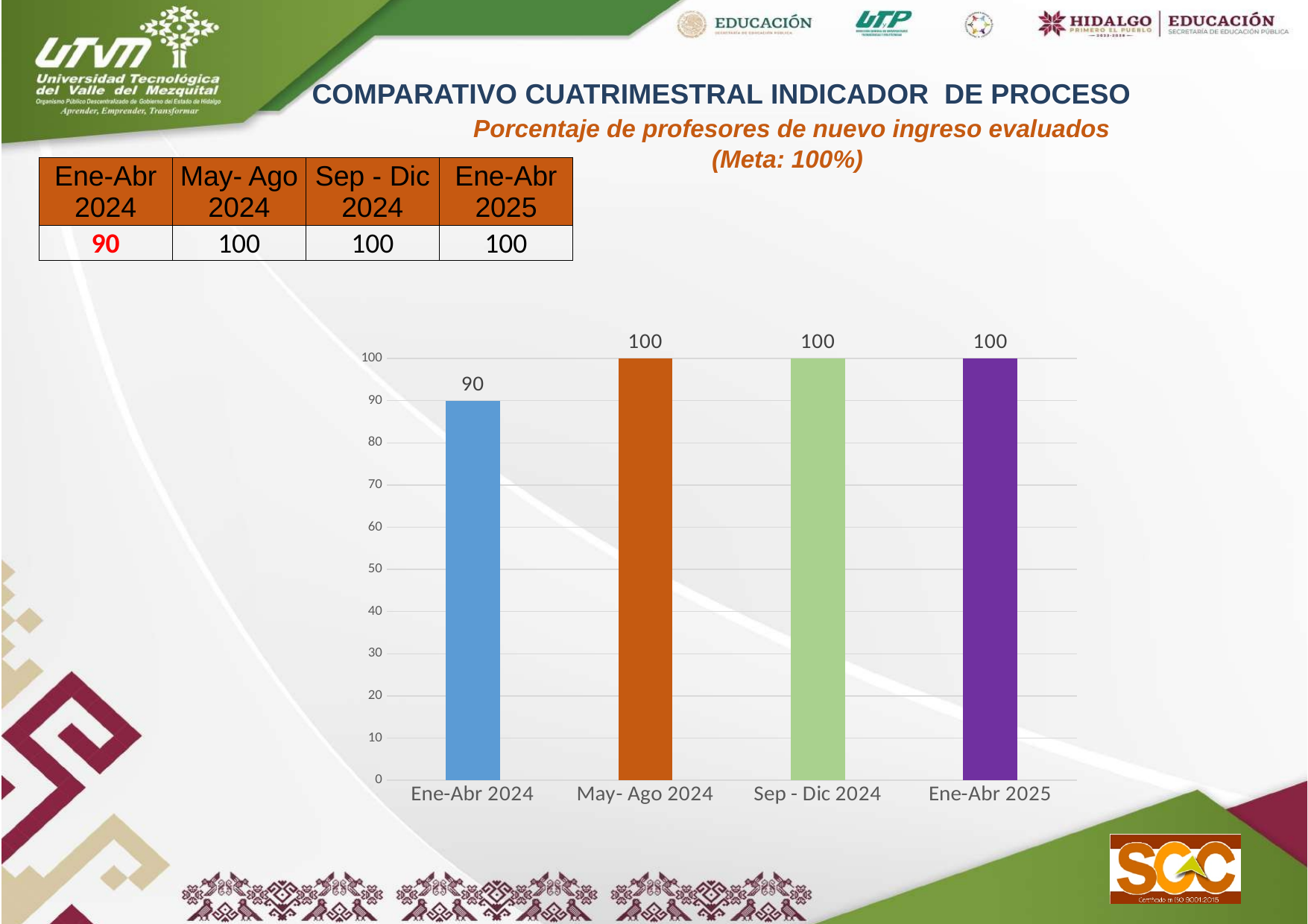
How many periods are shown on the x axis of the chart? 4 Do the values rise or fall from Ene-Abr 2024 to May- Ago 2024? rise What is the target (Meta) stated above the chart? 100% What is the value for Ene-Abr 2024? 90 What is the value for Sep - Dic 2024? 100 What is the value for Ene-Abr 2025? 100 What kind of chart is shown on the slide? bar chart What is the value for May- Ago 2024? 100 Which is larger, the value for Ene-Abr 2024 or the value for Sep - Dic 2024? Sep - Dic 2024 What is the difference between the value for May- Ago 2024 and the value for Ene-Abr 2024? 10 Which period has the lowest value? Ene-Abr 2024 Is the value for Ene-Abr 2024 greater or less than 80? greater